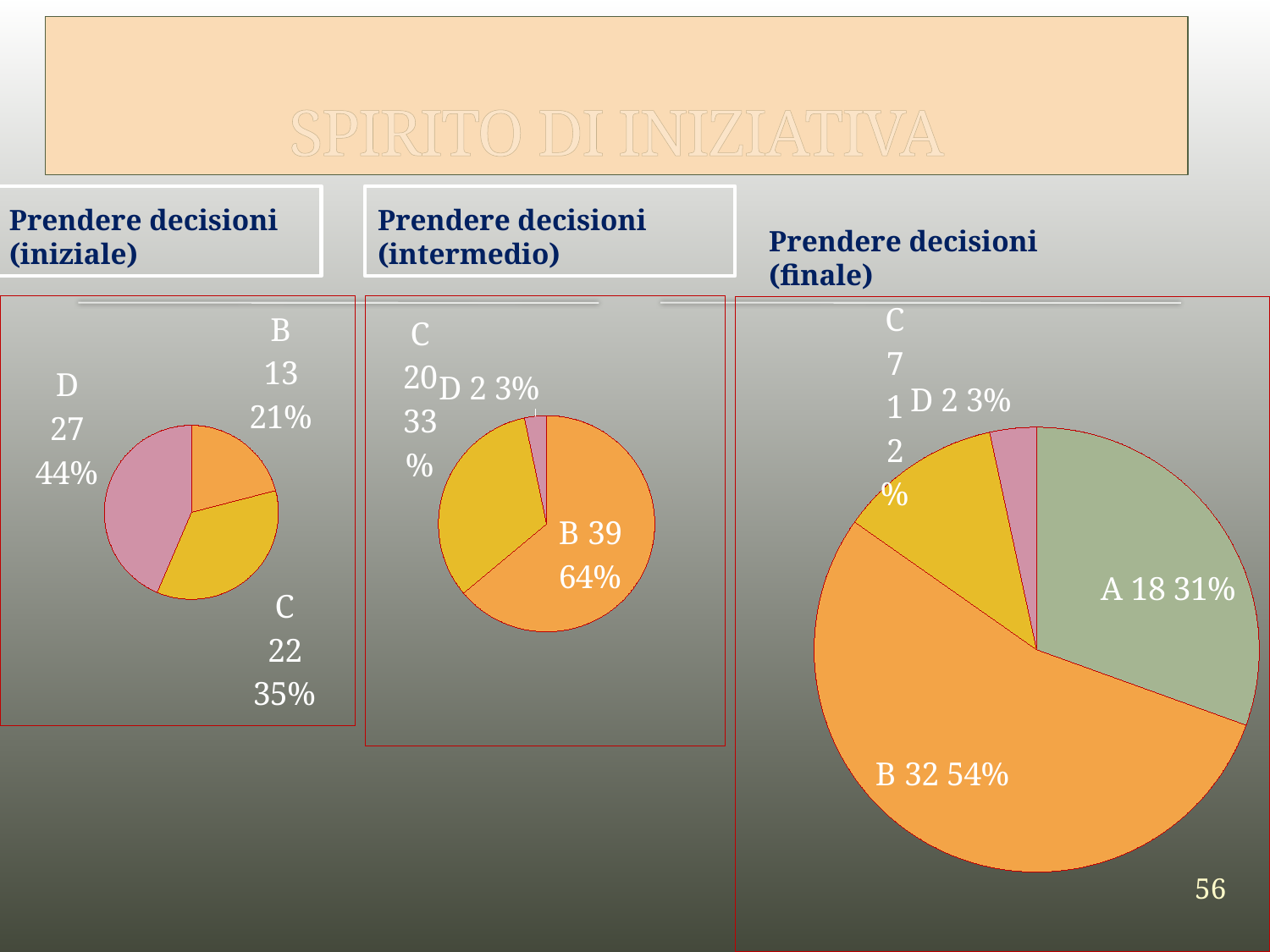
In the 'Prendere decisioni (iniziale)' chart, what percentage share does C have? 35% In the 'Prendere decisioni (intermedio)' chart, what is the difference between the values for B and C? 19 In the 'Prendere decisioni (finale)' chart, what value is shown for A? 18 In the 'Prendere decisioni (iniziale)' chart, how many slices does the pie have? 3 In the 'Prendere decisioni (finale)' chart, how many slices does the pie have? 4 In the 'Prendere decisioni (intermedio)' chart, which category has the smallest slice? D What kind of chart is used for 'Prendere decisioni (finale)'? Pie chart In the 'Prendere decisioni (intermedio)' chart, what percentage share does D have? 3% In the 'Prendere decisioni (intermedio)' chart, what value is shown for B? 39 In the 'Prendere decisioni (iniziale)' chart, which category has the largest slice? D In the 'Prendere decisioni (iniziale)' chart, what value is shown for D? 27 In the 'Prendere decisioni (finale)' chart, what percentage share does B have? 54%